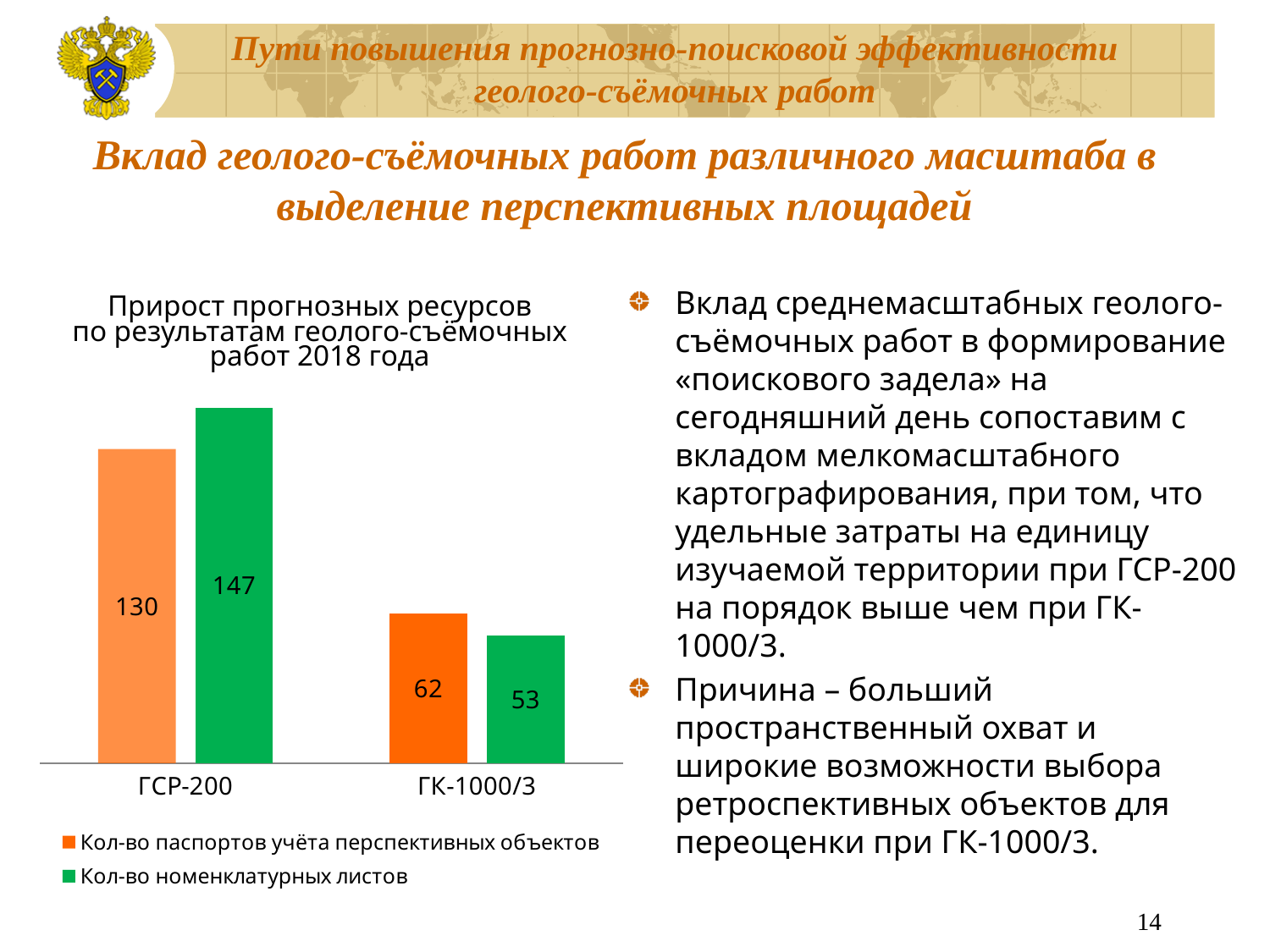
How many series does the chart legend list? 2 What is the difference between the two series values for ГК-1000/3? 9 What is the difference between 'Кол-во номенклатурных листов' for ГСР-200 and for ГК-1000/3? 94 Which category has the lowest value for 'Кол-во паспортов учёта перспективных объектов'? ГК-1000/3 How many categories are shown on the x axis of the chart? 2 What is the title of the chart? Прирост прогнозных ресурсов по результатам геолого-съёмочных работ 2018 года What is the value of 'Кол-во номенклатурных листов' for ГК-1000/3? 53 For ГСР-200, which is larger: 'Кол-во паспортов учёта перспективных объектов' or 'Кол-во номенклатурных листов'? Кол-во номенклатурных листов What is the value of 'Кол-во паспортов учёта перспективных объектов' for ГК-1000/3? 62 What kind of chart is shown on the slide? Bar chart Which category has the highest value for 'Кол-во номенклатурных листов'? ГСР-200 What is the value of 'Кол-во паспортов учёта перспективных объектов' for ГСР-200? 130